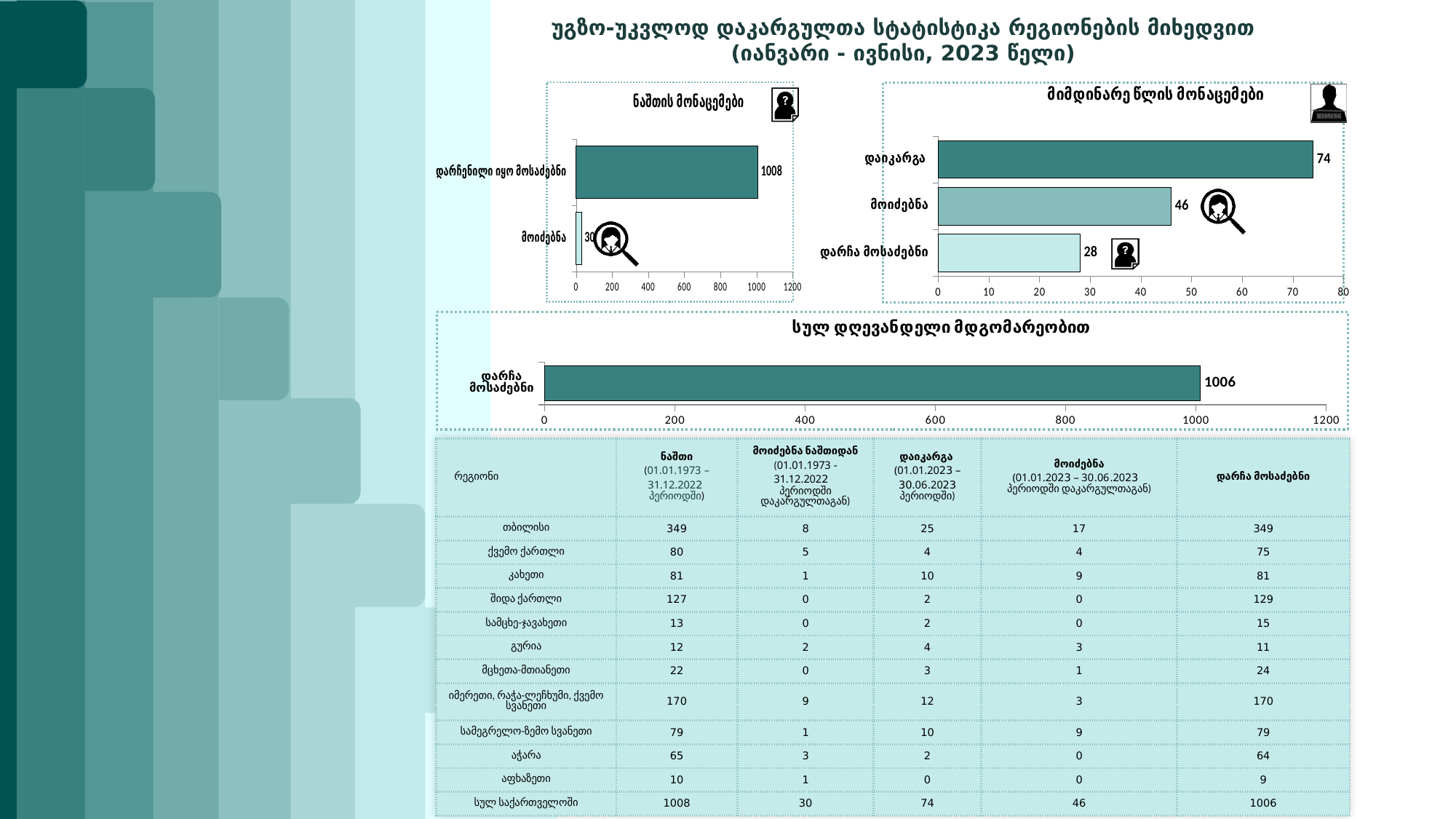
In the top-left chart titled "ნაშთის მონაცემები", what is the value for "მოიძებნა"? 30 In the top-right chart titled "მიმდინარე წლის მონაცემები", which category has the highest value? დაიკარგა What type of chart is the bottom chart titled "სულ დღევანდელი მდგომარეობით"? Bar chart In the top-right chart titled "მიმდინარე წლის მონაცემები", what is the difference between "დაიკარგა" and "მოიძებნა"? 28 In the top-left chart titled "ნაშთის მონაცემები", what is the difference between "დარჩენილი იყო მოსაძებნი" and "მოიძებნა"? 978 In the top-right chart titled "მიმდინარე წლის მონაცემები", what is the value for "დაიკარგა"? 74 How many categories are shown in the top-right chart titled "მიმდინარე წლის მონაცემები"? 3 In the top-right chart titled "მიმდინარე წლის მონაცემები", what is the value for "მოიძებნა"? 46 In the top-left chart titled "ნაშთის მონაცემები", what is the value for "დარჩენილი იყო მოსაძებნი"? 1008 In the top-right chart titled "მიმდინარე წლის მონაცემები", what is the value for "დარჩა მოსაძებნი"? 28 In the bottom chart titled "სულ დღევანდელი მდგომარეობით", what is the value for "დარჩა მოსაძებნი"? 1006 In the top-right chart titled "მიმდინარე წლის მონაცემები", which category has the lowest value? დარჩა მოსაძებნი